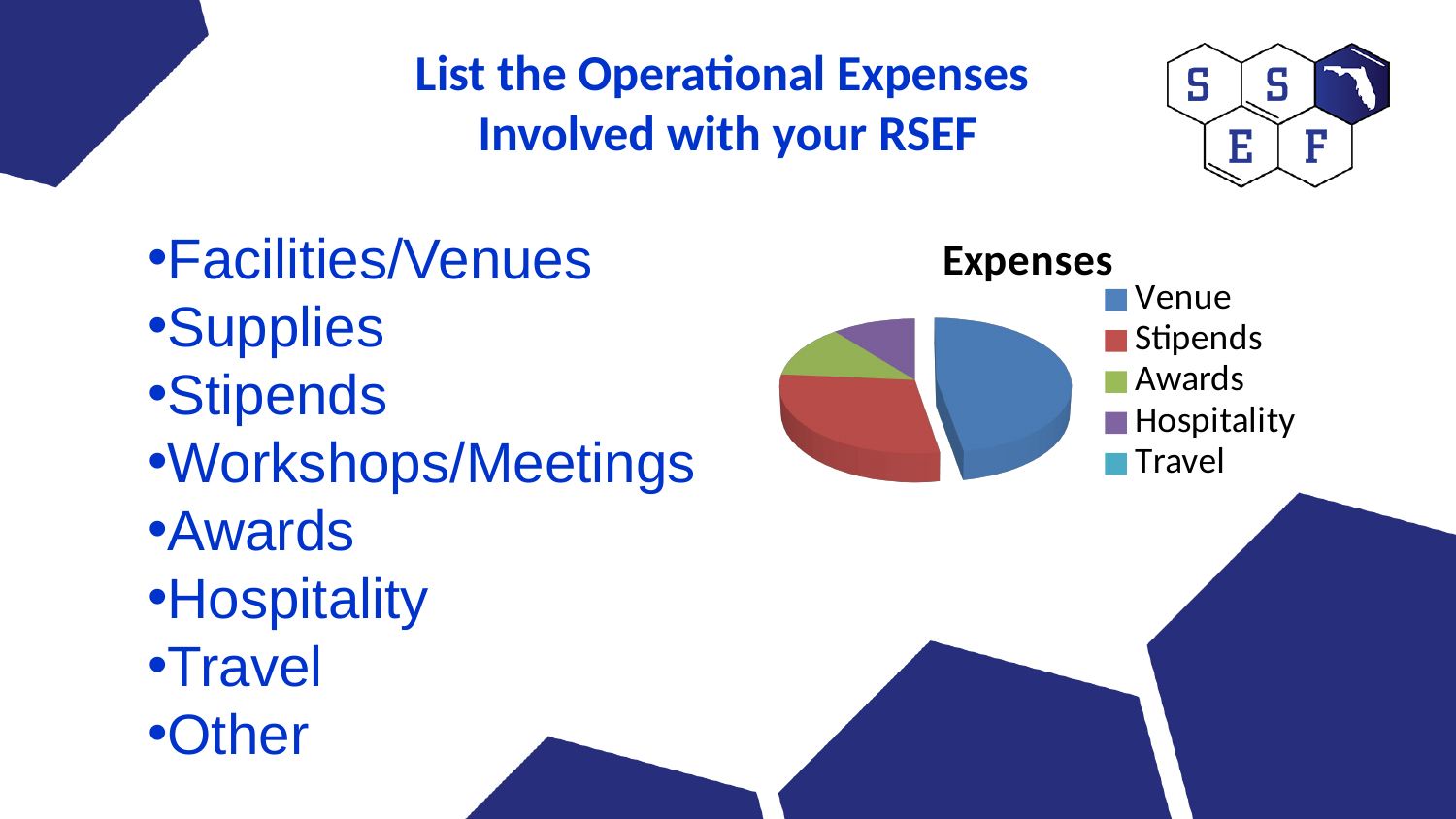
In the Expenses pie chart, which slice is larger, Stipends or Awards? Stipends In the Expenses pie chart, which slice is larger, Venue or Stipends? Venue Which category is listed last in the legend of the Expenses pie chart? Travel What kind of chart is shown on the slide? pie chart What is the title of the chart? Expenses In the Expenses pie chart, which slice is larger, Awards or Hospitality? Awards Which colour represents Venue in the Expenses pie chart? blue Which category has the largest slice in the Expenses pie chart? Venue How many categories does the legend of the Expenses pie chart list? 5